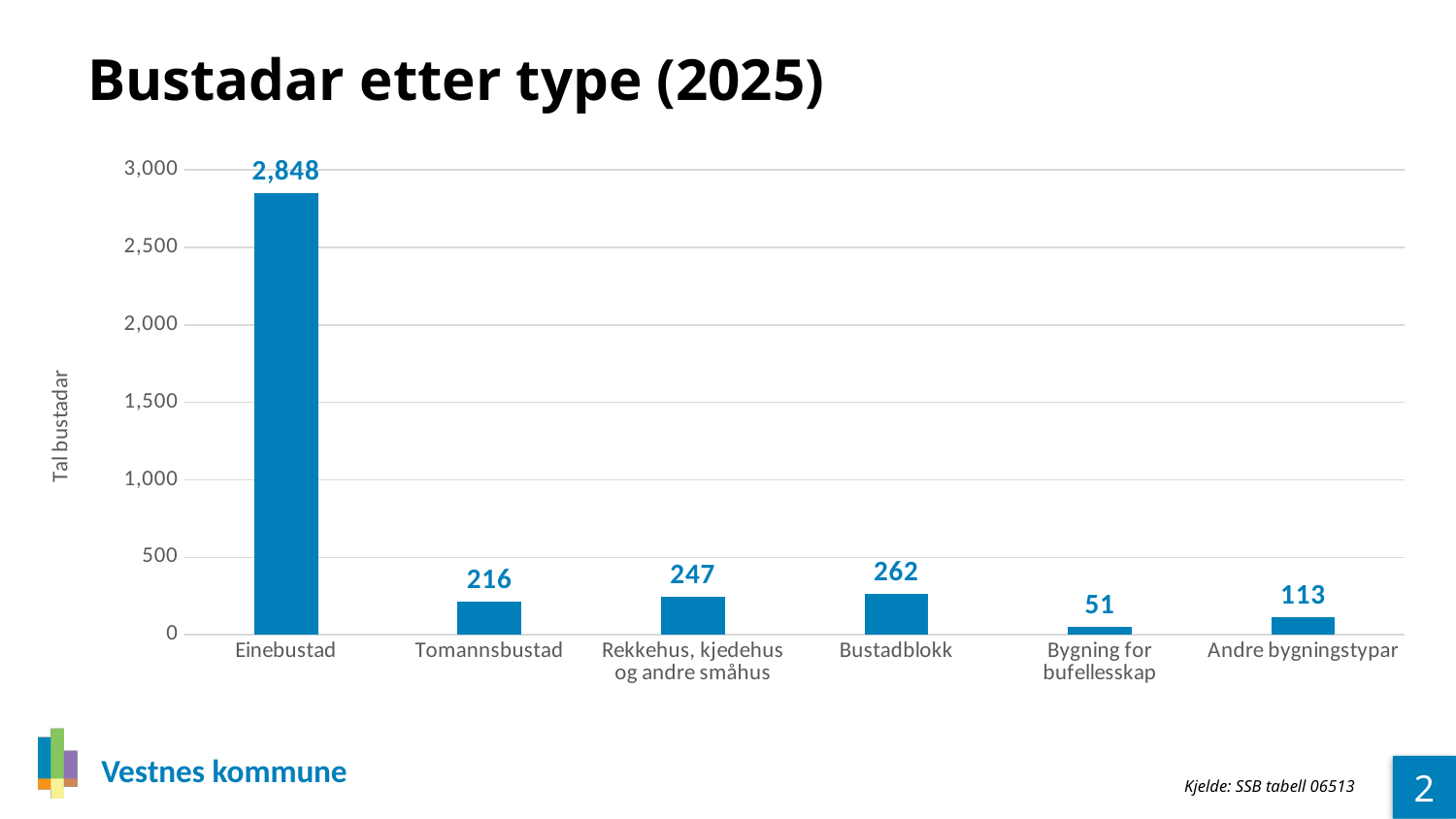
What is the value for Bygning for bufellesskap? 51 What is the difference between the values for Bustadblokk and Tomannsbustad? 46 Which category has the lowest value? Bygning for bufellesskap How many categories are shown on the x axis? 6 Is the value for Bustadblokk greater or less than 500? less What kind of chart is shown on the slide? bar chart What is the value for Tomannsbustad? 216 What is the value for Andre bygningstypar? 113 Which is larger, the value for Rekkehus, kjedehus og andre småhus or the value for Andre bygningstypar? Rekkehus, kjedehus og andre småhus What is the value for Einebustad? 2,848 What is the title of the chart? Bustadar etter type (2025) Which category has the highest value? Einebustad